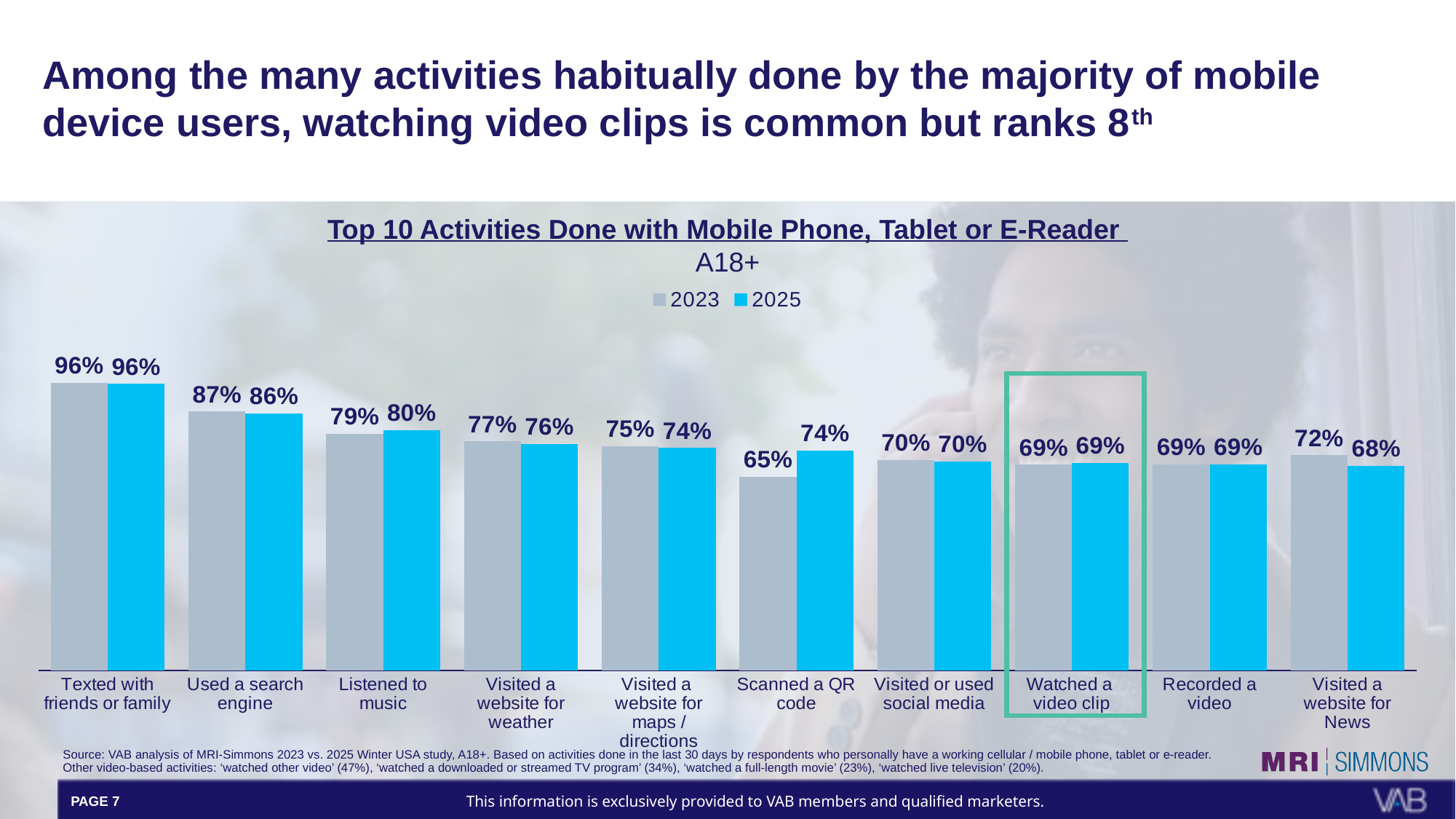
What kind of chart is shown? Bar chart Which activity is highlighted with a green box? Watched a video clip Which activity has the highest 2025 value? Texted with friends or family What is the difference between the 2023 and 2025 values for 'Scanned a QR code'? 9% What is the 2023 value for 'Visited a website for News'? 72% How many series does the legend list? 2 Which is larger: the 2025 value for 'Visited a website for weather' or the 2025 value for 'Visited a website for News'? Visited a website for weather How many activities are shown on the x axis? 10 What is the difference between the 2023 values for 'Used a search engine' and 'Listened to music'? 8% What is the 2025 value for 'Listened to music'? 80% What is the 2025 value for 'Scanned a QR code'? 74% Which activity has the lowest 2023 value? Scanned a QR code